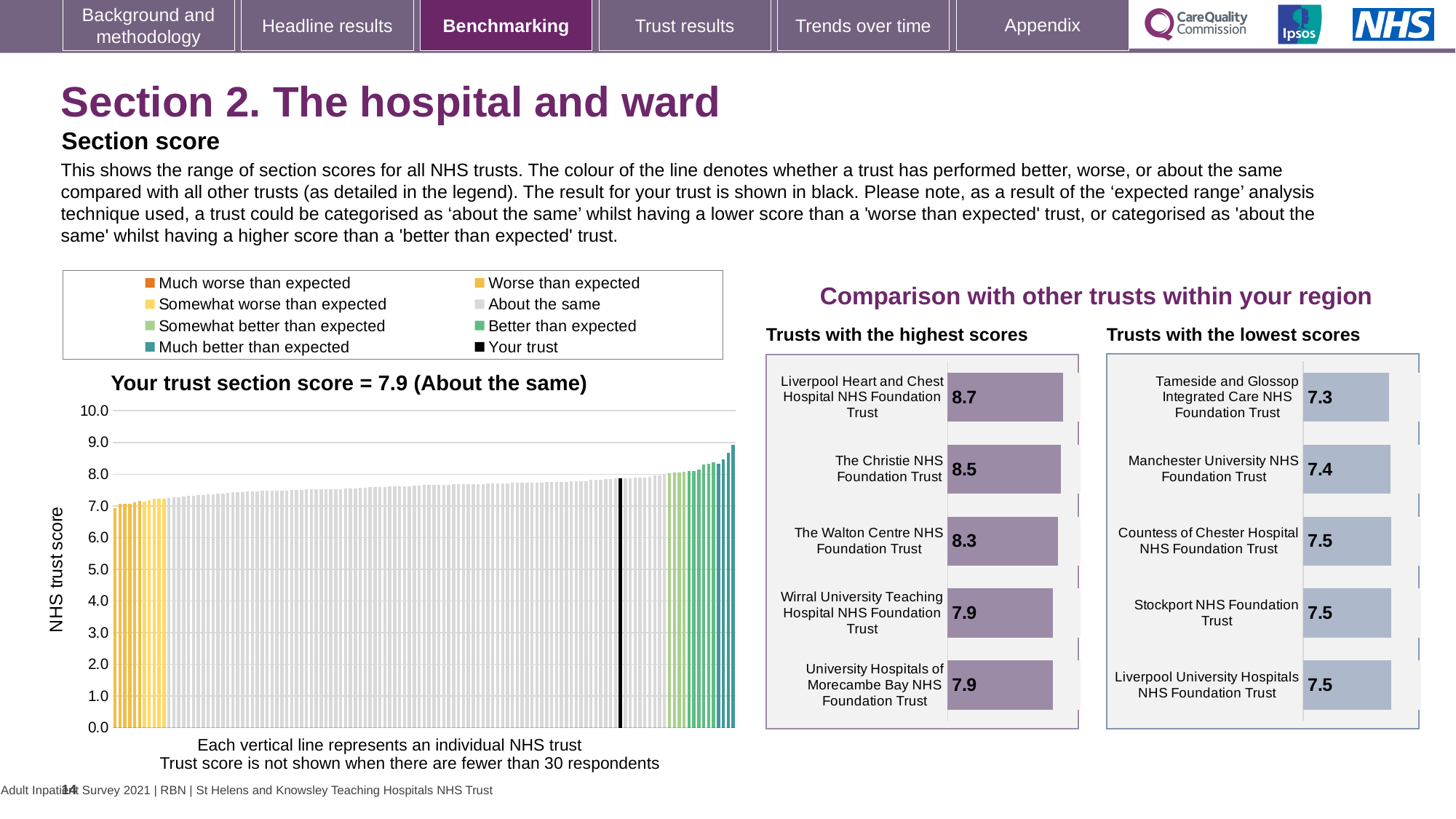
In the 'Trusts with the highest scores' chart, which trust has the highest score? Liverpool Heart and Chest Hospital NHS Foundation Trust How many entries does the legend above the main chart on the left list? 8 In the 'Trusts with the lowest scores' chart, which trust has the lowest score? Tameside and Glossop Integrated Care NHS Foundation Trust In the 'Trusts with the lowest scores' chart, what is the score for Manchester University NHS Foundation Trust? 7.4 What kind of chart is the main chart on the left titled 'Your trust section score = 7.9 (About the same)'? bar chart In the 'Trusts with the lowest scores' chart, which has the larger score: Manchester University NHS Foundation Trust or Tameside and Glossop Integrated Care NHS Foundation Trust? Manchester University NHS Foundation Trust In the 'Trusts with the highest scores' chart, what is the difference between the scores of Liverpool Heart and Chest Hospital NHS Foundation Trust and The Walton Centre NHS Foundation Trust? 0.4 In the main chart on the left, do the trust scores rise or fall from left to right along the x axis? rise How many trusts are shown in the 'Trusts with the highest scores' chart? 5 In the 'Trusts with the highest scores' chart, what is the score for The Christie NHS Foundation Trust? 8.5 In the 'Trusts with the lowest scores' chart, what is the difference between the scores of Stockport NHS Foundation Trust and Tameside and Glossop Integrated Care NHS Foundation Trust? 0.2 According to the title of the main chart on the left, what is your trust's section score? 7.9